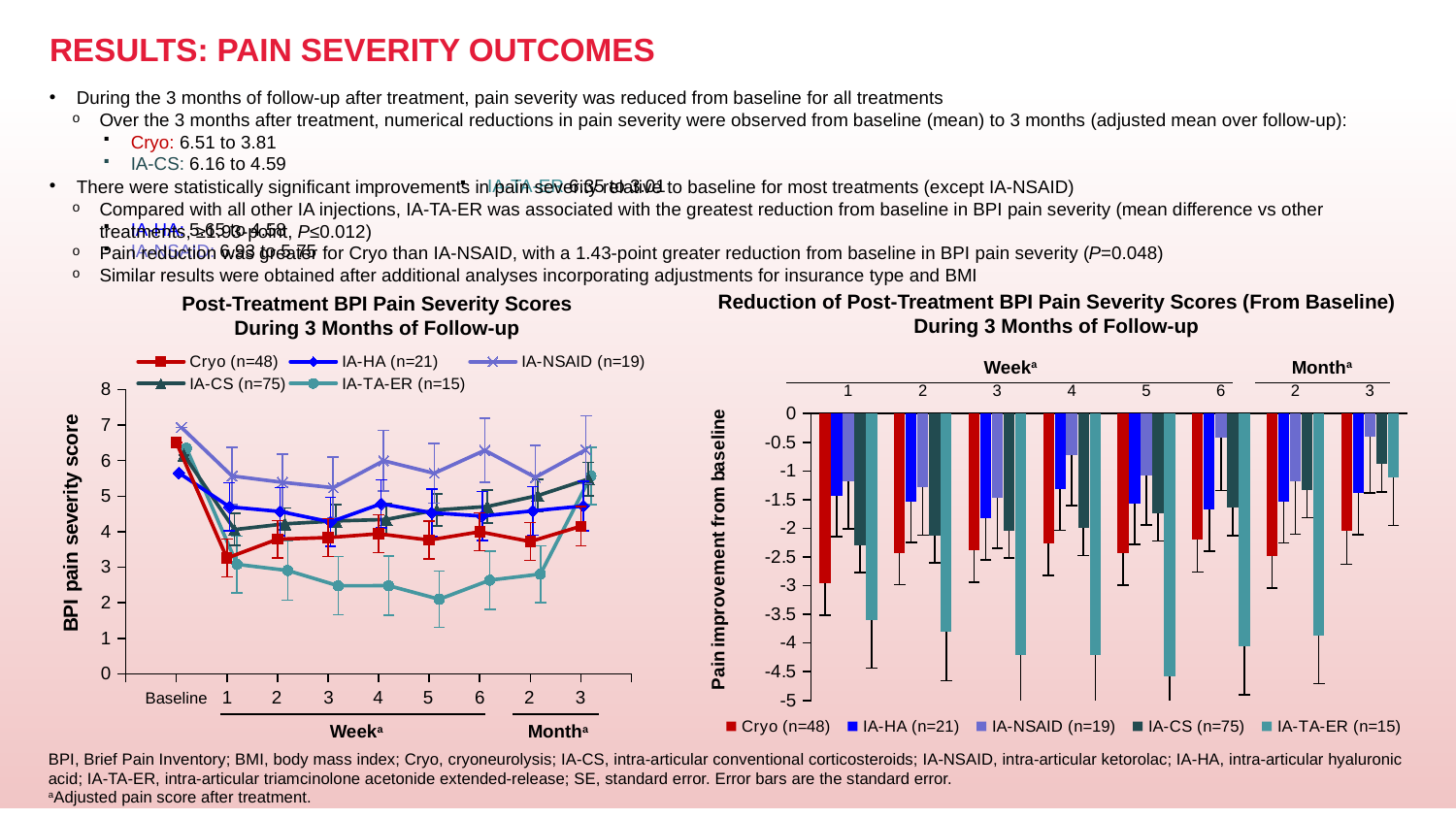
In the left chart (Post-Treatment BPI Pain Severity Scores), how many series does the legend list? 5 In the left chart (Post-Treatment BPI Pain Severity Scores), is the IA-TA-ER value at week 5 greater or less than 3? less What kind of chart is the left chart titled 'Post-Treatment BPI Pain Severity Scores During 3 Months of Follow-up'? Line chart In the right chart (Reduction of Post-Treatment BPI Pain Severity Scores), how many series does the legend list? 5 In the left chart (Post-Treatment BPI Pain Severity Scores), what sample size does the legend give for IA-CS? n=75 In the left chart (Post-Treatment BPI Pain Severity Scores), is the IA-NSAID value at Baseline greater or less than 6? greater In the left chart (Post-Treatment BPI Pain Severity Scores), which has the higher pain severity score at week 5, IA-NSAID or IA-TA-ER? IA-NSAID In the right chart (Reduction of Post-Treatment BPI Pain Severity Scores), is the IA-TA-ER value at week 5 greater or less than -4? less In the left chart (Post-Treatment BPI Pain Severity Scores), how many time points are shown on the x axis, including Baseline? 9 What kind of chart is the right chart titled 'Reduction of Post-Treatment BPI Pain Severity Scores (From Baseline) During 3 Months of Follow-up'? Bar chart In the right chart (Reduction of Post-Treatment BPI Pain Severity Scores), which treatment has the lowest (most negative) bar at week 5? IA-TA-ER (n=15) In the right chart (Reduction of Post-Treatment BPI Pain Severity Scores), how many time-point groups of bars are shown on the x axis? 8